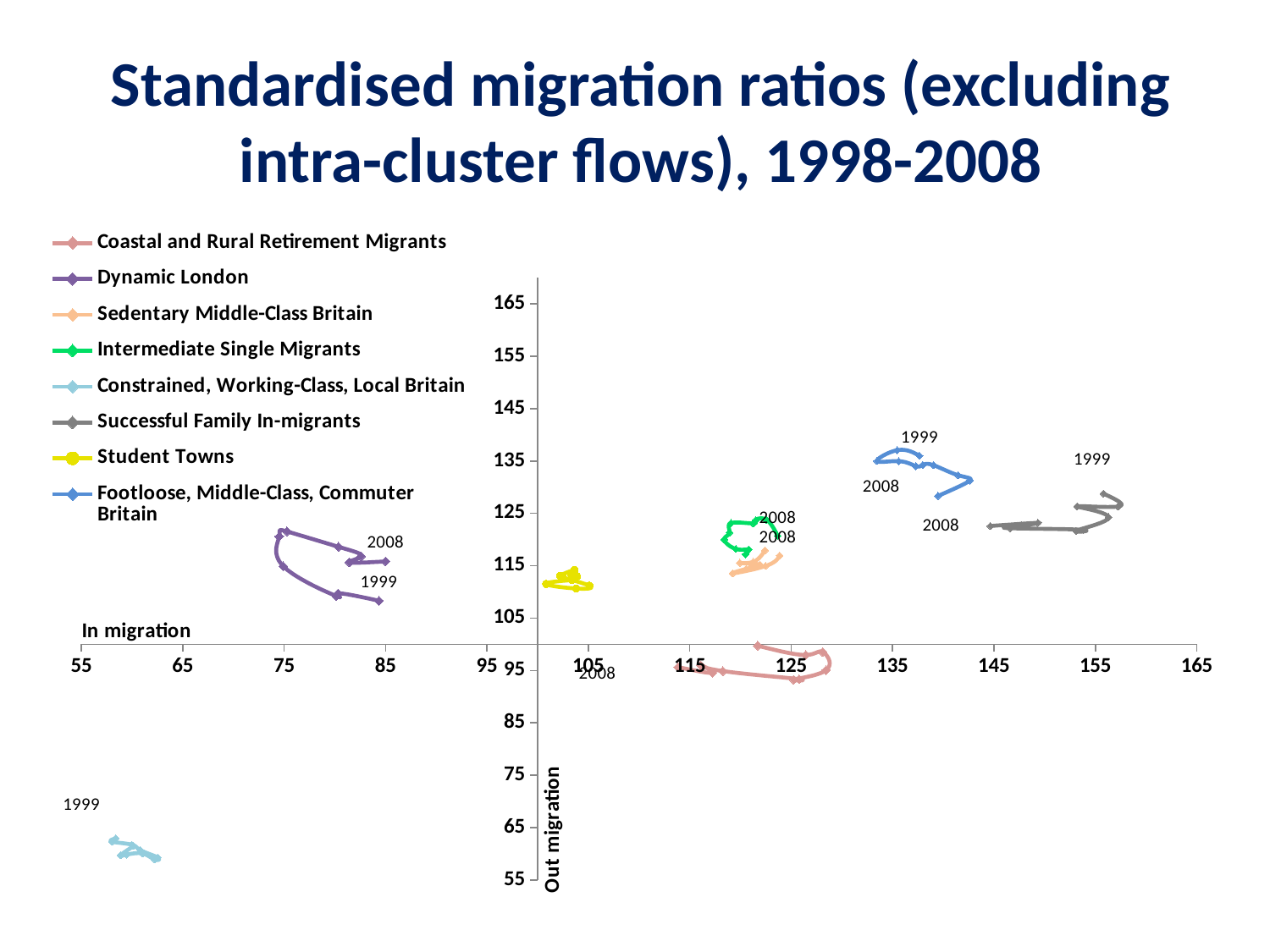
Are the out migration values for Constrained, Working-Class, Local Britain greater or less than 65? less Are the out migration values for Footloose, Middle-Class, Commuter Britain greater or less than 125? greater Which series has the lowest in migration values? Constrained, Working-Class, Local Britain Are the in migration values for Dynamic London greater or less than 95? less What is the label of the horizontal axis? In migration Which series has the highest out migration values? Footloose, Middle-Class, Commuter Britain How many series does the legend list? 8 What is the label of the vertical axis? Out migration Which series has higher in migration values, Successful Family In-migrants or Dynamic London? Successful Family In-migrants Which series has the highest in migration values? Successful Family In-migrants What kind of chart is shown on the slide? Scatter chart with connected lines